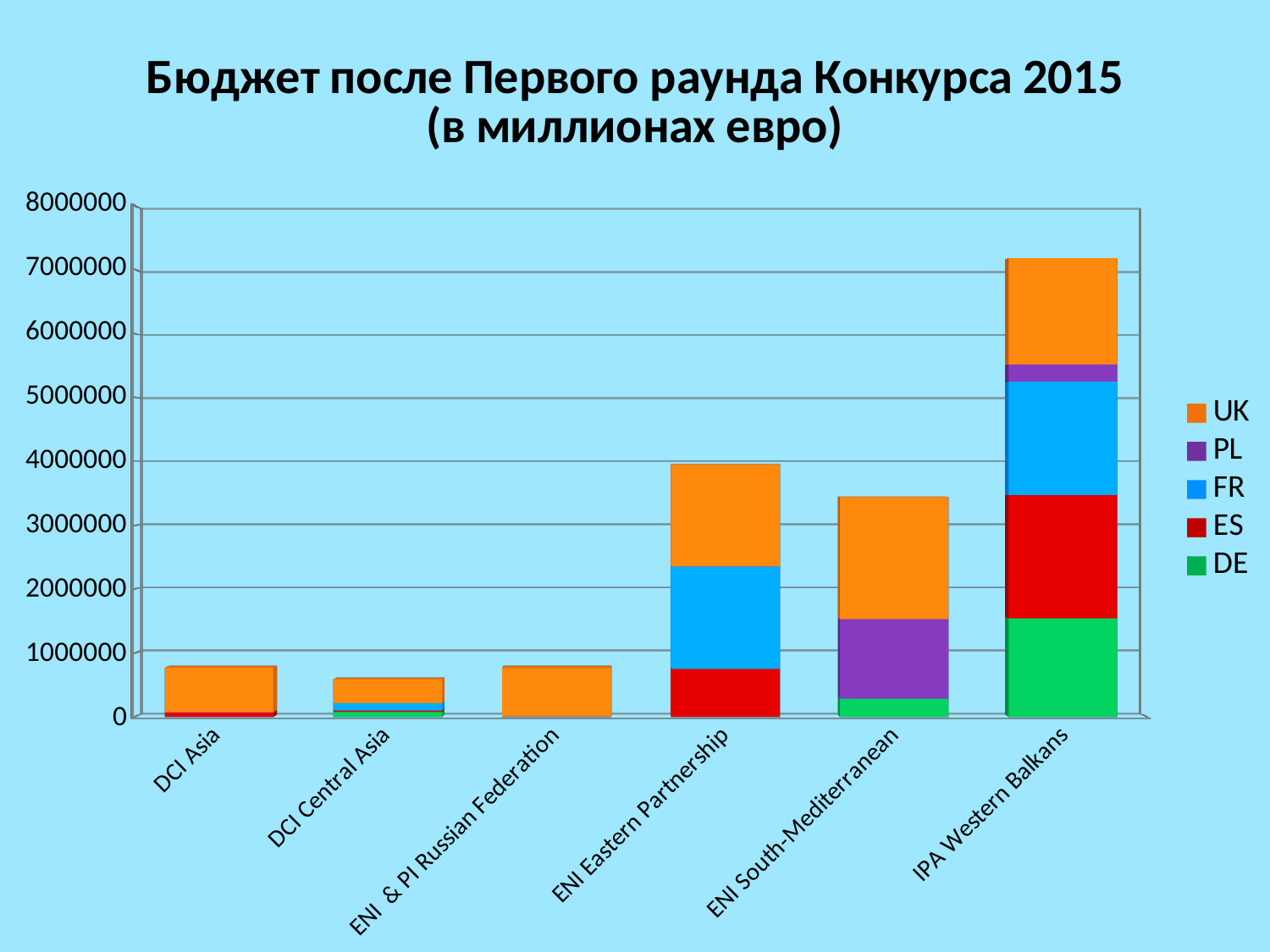
Which series is listed last in the legend? DE Which category has the highest total bar? IPA Western Balkans Which series is shown in orange in the legend? UK How many categories are shown on the x axis of the chart? 6 Which has a larger total bar, ENI Eastern Partnership or ENI South-Mediterranean? ENI Eastern Partnership Is the total value for IPA Western Balkans greater or less than 6000000? greater What kind of chart is shown on the slide? stacked bar chart Which category has the lowest total bar? DCI Central Asia Which has a larger total bar, DCI Asia or IPA Western Balkans? IPA Western Balkans Is the total value for DCI Asia greater or less than 1000000? less Is the total value for ENI Eastern Partnership greater or less than 3000000? greater How many series does the legend list? 5